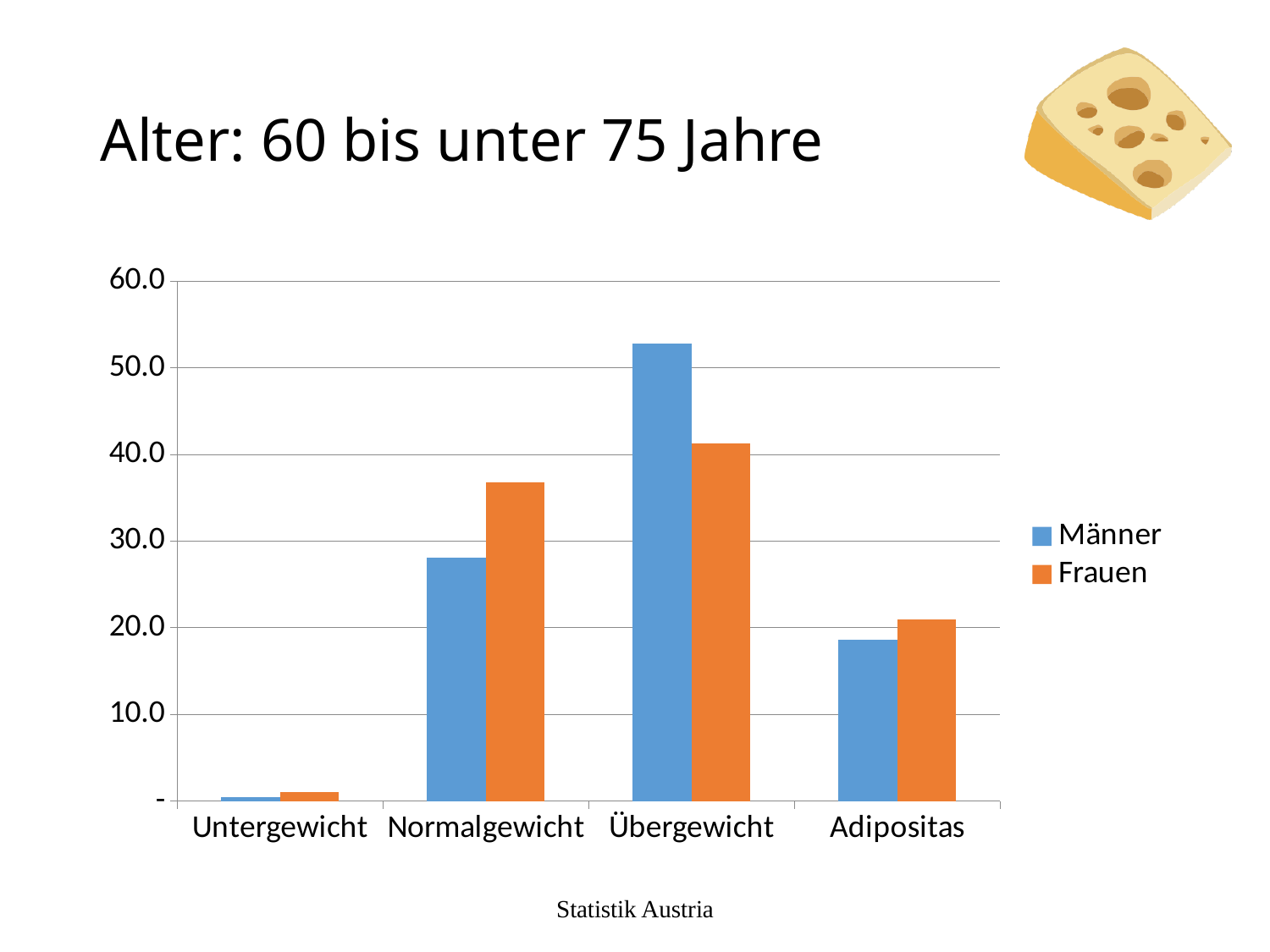
In Normalgewicht, which series has the larger value, Männer or Frauen? Frauen Is the value for Männer in Übergewicht greater or less than 50? greater How many categories are shown on the x axis? 4 In Übergewicht, which series has the larger value, Männer or Frauen? Männer How many series does the legend list? 2 Is the value for Frauen in Übergewicht greater or less than 50? less Is the value for Frauen in Normalgewicht greater or less than 30? greater What kind of chart is shown on the slide? bar chart Which category has the highest value for Männer? Übergewicht Which category has the highest value for Frauen? Übergewicht Which category has the lowest value for Männer? Untergewicht